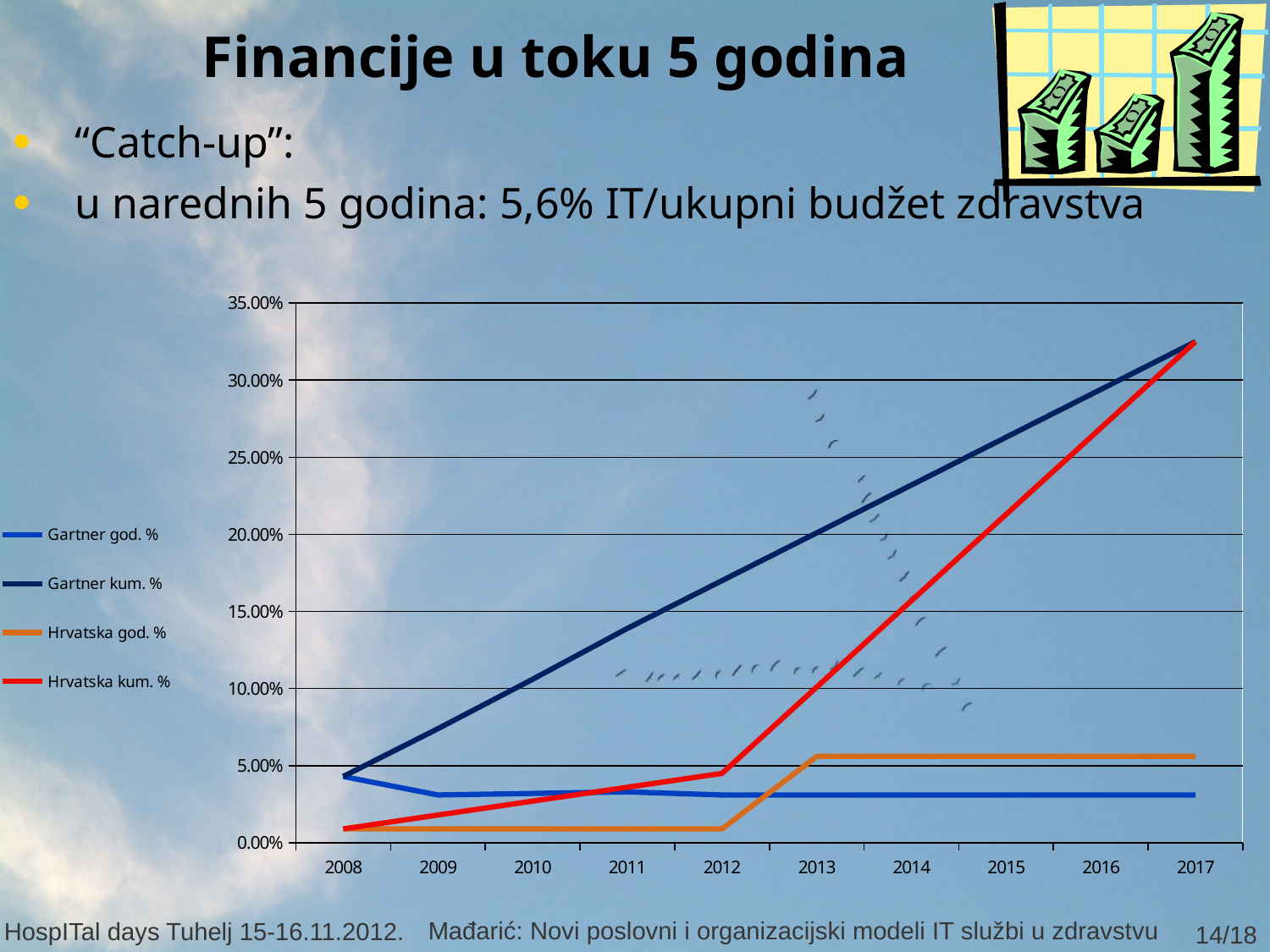
What kind of chart is shown on the slide? line chart Does the Gartner god. % series rise or fall from 2008 to 2017? falls Does the Gartner kum. % series rise or fall from 2008 to 2017? rises Which series has the highest value in 2014? Gartner kum. % Is the value for Hrvatska kum. % in 2010 greater or less than 5.00%? less Is the value for Gartner kum. % in 2017 greater or less than 30.00%? greater Is the value for Gartner kum. % in 2011 greater or less than 10.00%? greater In 2008, which is higher: Gartner god. % or Hrvatska god. %? Gartner god. % How many years are shown on the x axis of the chart? 10 Which series has the lowest value in 2010? Hrvatska god. % How many series does the chart legend list? 4